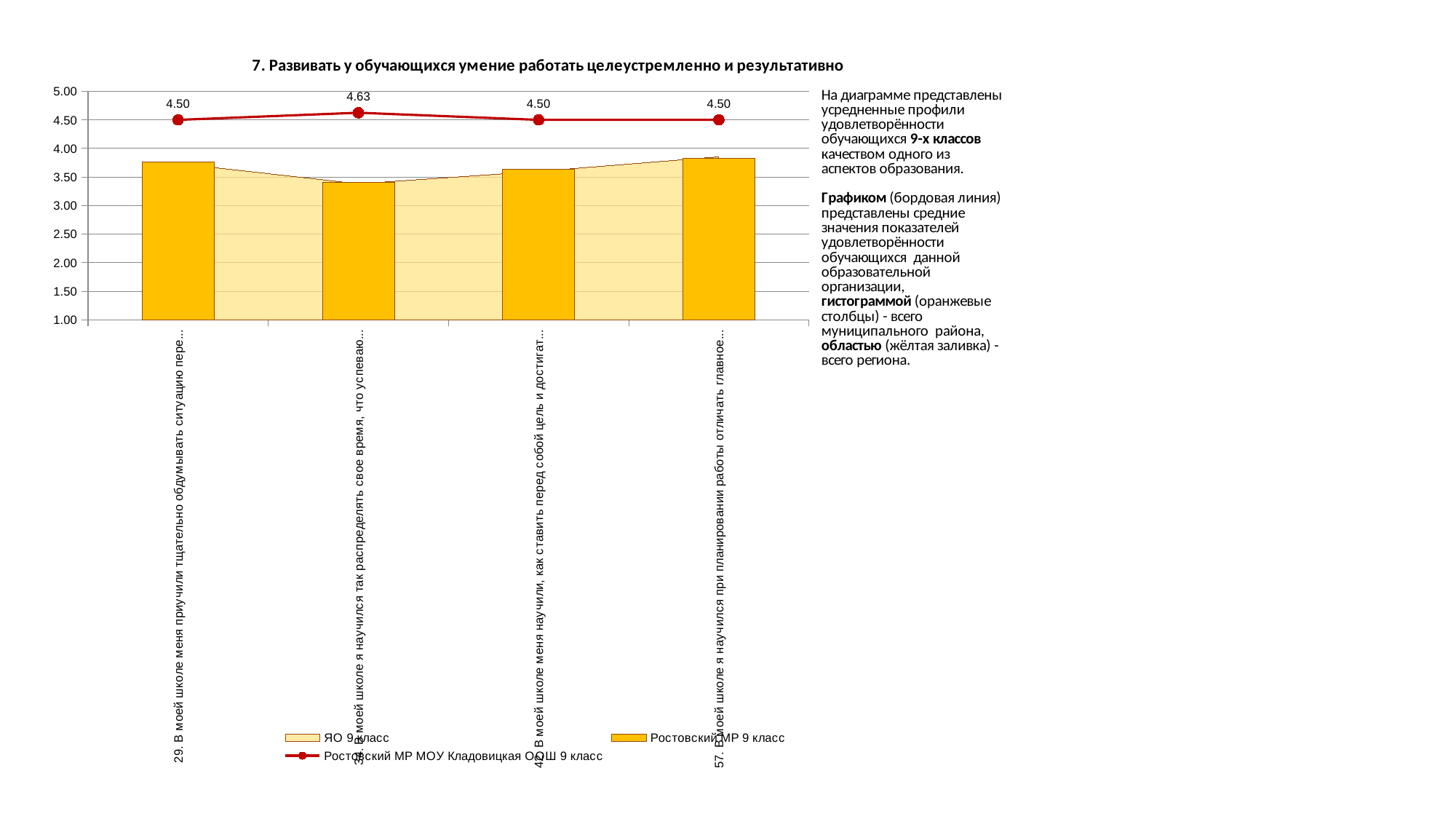
What is the value of the line series 'Ростовский МР МОУ Кладовицкая ООШ 9 класс' for category 57 (В моей школе я научился при планировании работы отличать главное...)? 4.50 What is the value of the line series 'Ростовский МР МОУ Кладовицкая ООШ 9 класс' for category 29 (В моей школе меня приучили тщательно обдумывать ситуацию...)? 4.50 What is the title of the chart? 7. Развивать у обучающихся умение работать целеустремленно и результативно What kind of chart is used for the series 'Ростовский МР 9 класс'? bar chart How many series does the chart legend list? 3 Is the 'Ростовский МР 9 класс' bar for category 57 greater or less than 4.00? less What is the difference between the highest and lowest values of the line series 'Ростовский МР МОУ Кладовицкая ООШ 9 класс'? 0.13 How many categories are shown on the x axis of the chart? 4 What is the value of the line series 'Ростовский МР МОУ Кладовицкая ООШ 9 класс' for the second category (В моей школе я научился так распределять свое время...)? 4.63 Is the 'Ростовский МР 9 класс' bar for category 29 greater or less than 3.50? greater Which 'Ростовский МР 9 класс' bar is larger: the one for category 57 or the one for the second category (В моей школе я научился так распределять свое время...)? category 57 For which category is the line series 'Ростовский МР МОУ Кладовицкая ООШ 9 класс' highest? В моей школе я научился так распределять свое время, что успеваю... (second category)